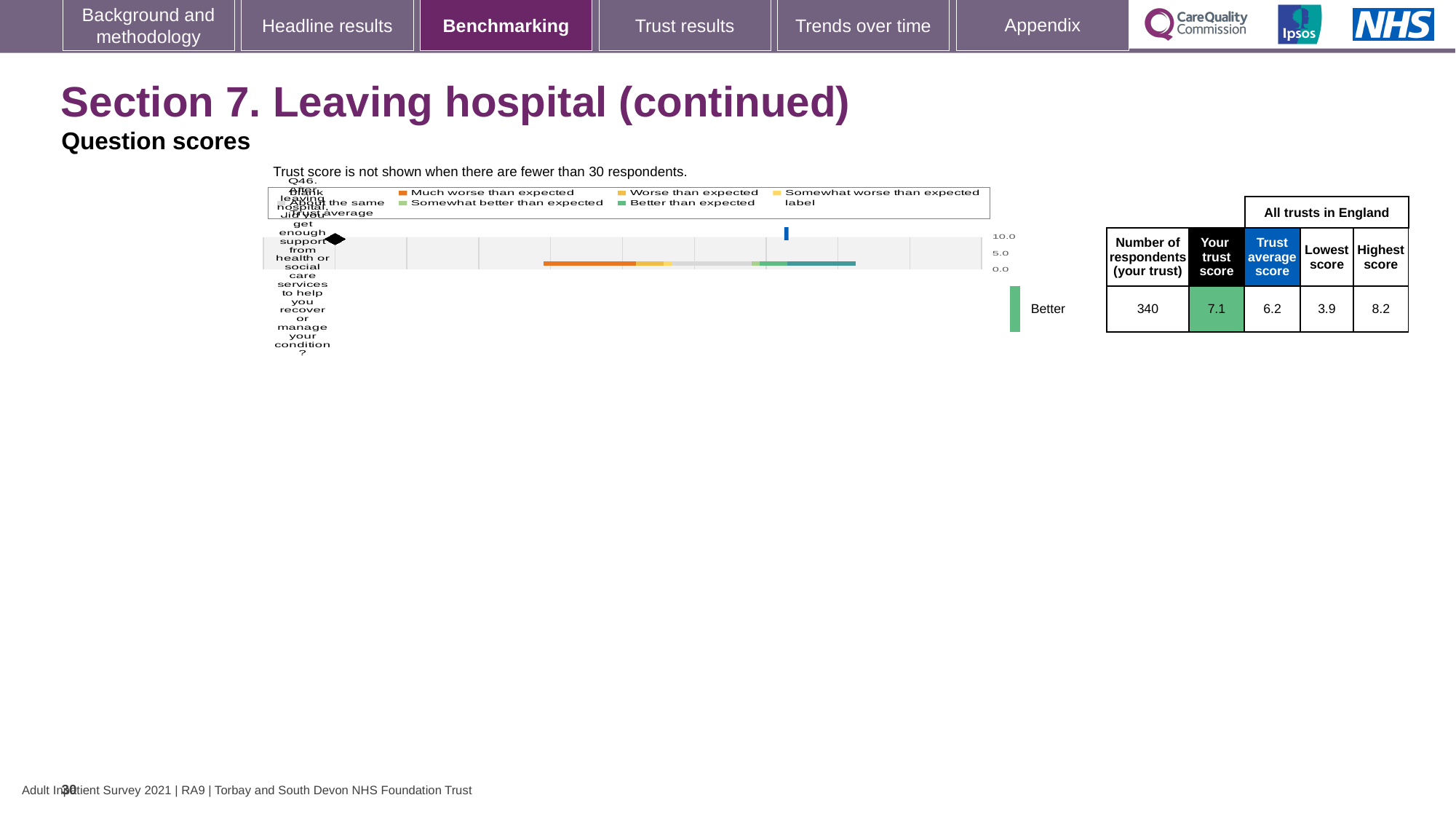
What is the difference between the highest and lowest scores for Q46 across all trusts in England? 4.3 What is the highest score among all trusts in England for Q46? 8.2 What is the number of respondents (your trust) shown for Q46? 340 What kind of chart is used to show the benchmarking result for Q46? Bar chart What is the trust average score for Q46? 6.2 What benchmark rating label is shown next to the chart for Q46? Better How many questions are plotted on the benchmarking chart? 1 By how much does your trust score for Q46 exceed the trust average score? 0.9 Is your trust score for Q46 greater or less than 5.0 on the chart's axis? greater What is the lowest score among all trusts in England for Q46? 3.9 What is your trust score for Q46? 7.1 Which is larger for Q46: your trust score or the trust average score? Your trust score